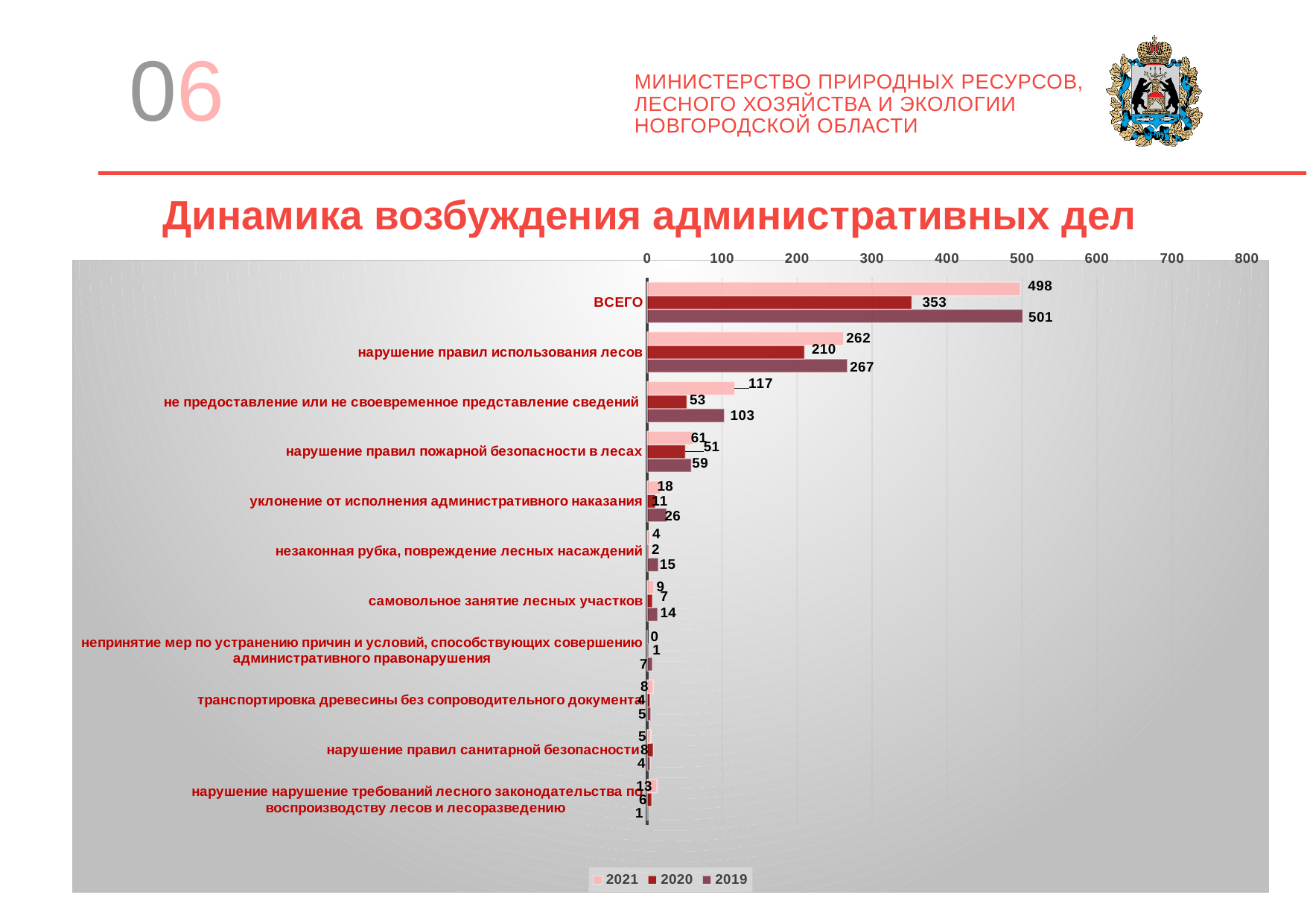
What is the value for ВСЕГО in 2020? 353 What is the title of the chart? Динамика возбуждения административных дел What type of chart is shown on the slide? bar chart Is the 2020 value for 'нарушение правил использования лесов' greater or less than 300? less What is the difference between the 2019 and 2020 values for ВСЕГО? 148 Which year has the highest value for 'уклонение от исполнения административного наказания'? 2019 What is the 2019 value for 'нарушение правил использования лесов'? 267 How many series does the legend list? 3 What is the 2021 value for 'не предоставление или не своевременное представление сведений'? 117 Which is larger: the 2021 value or the 2019 value for 'нарушение правил пожарной безопасности в лесах'? 2021 What is the value for ВСЕГО in 2021? 498 Which year has the lowest value for 'незаконная рубка, повреждение лесных насаждений'? 2020